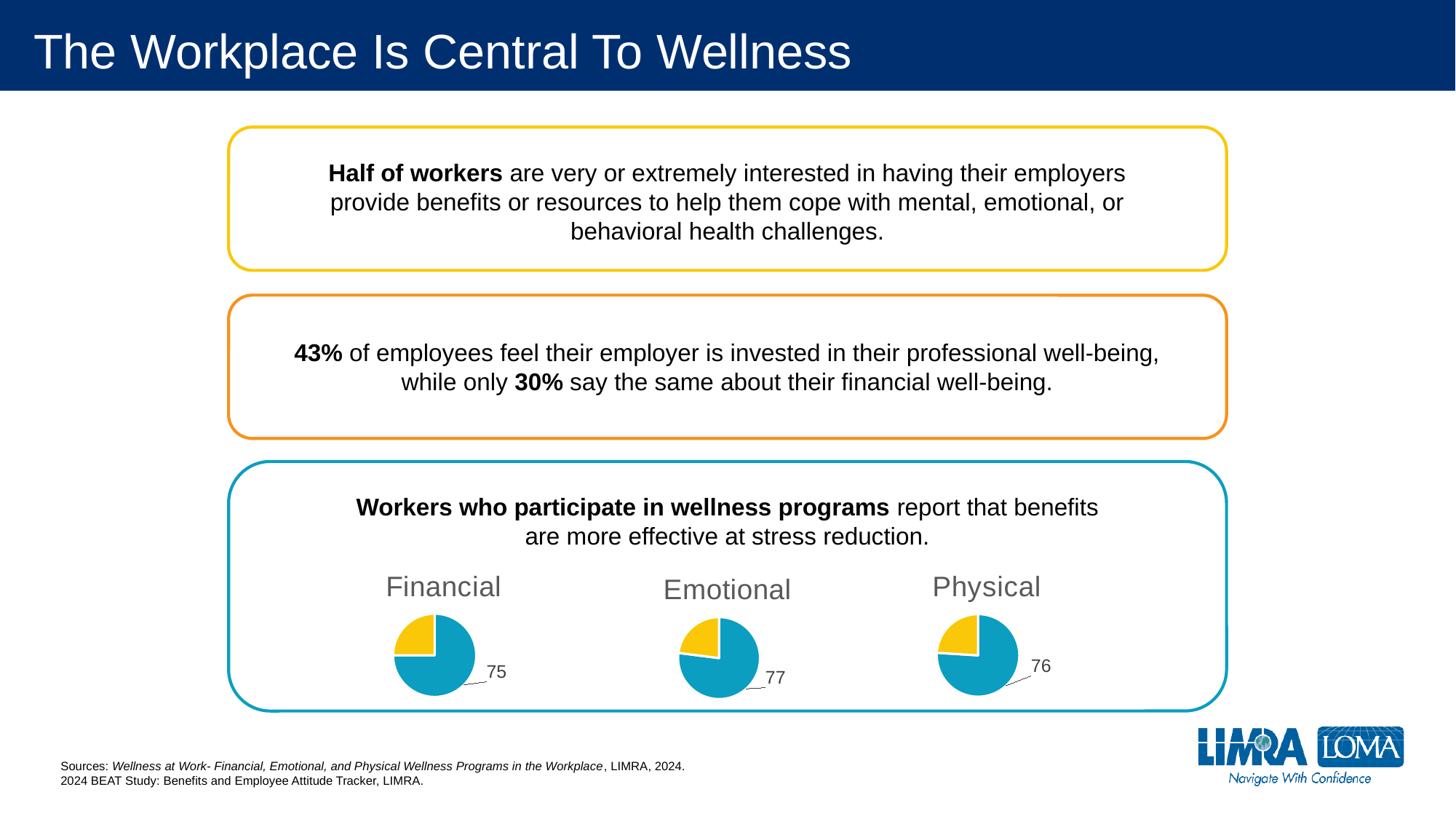
In the Physical pie chart, what value is printed on the labeled slice? 76 Which pie chart has the larger labeled value, Emotional or Physical? Emotional How many pie charts are shown on the slide? 3 In the Financial pie chart, what value is printed on the labeled slice? 75 Among the three pie charts (Financial, Emotional, Physical), which has the highest labeled value? Emotional Among the three pie charts (Financial, Emotional, Physical), which has the lowest labeled value? Financial In the Emotional pie chart, what value is printed on the labeled slice? 77 In the Financial pie chart, what colour is the slice labeled 75? Blue What are the titles of the three pie charts, from left to right? Financial, Emotional, Physical What kind of chart is used to show the Financial, Emotional, and Physical values? Pie chart What is the difference between the labeled value in the Physical pie chart and the labeled value in the Financial pie chart? 1 What is the difference between the labeled value in the Emotional pie chart and the labeled value in the Financial pie chart? 2